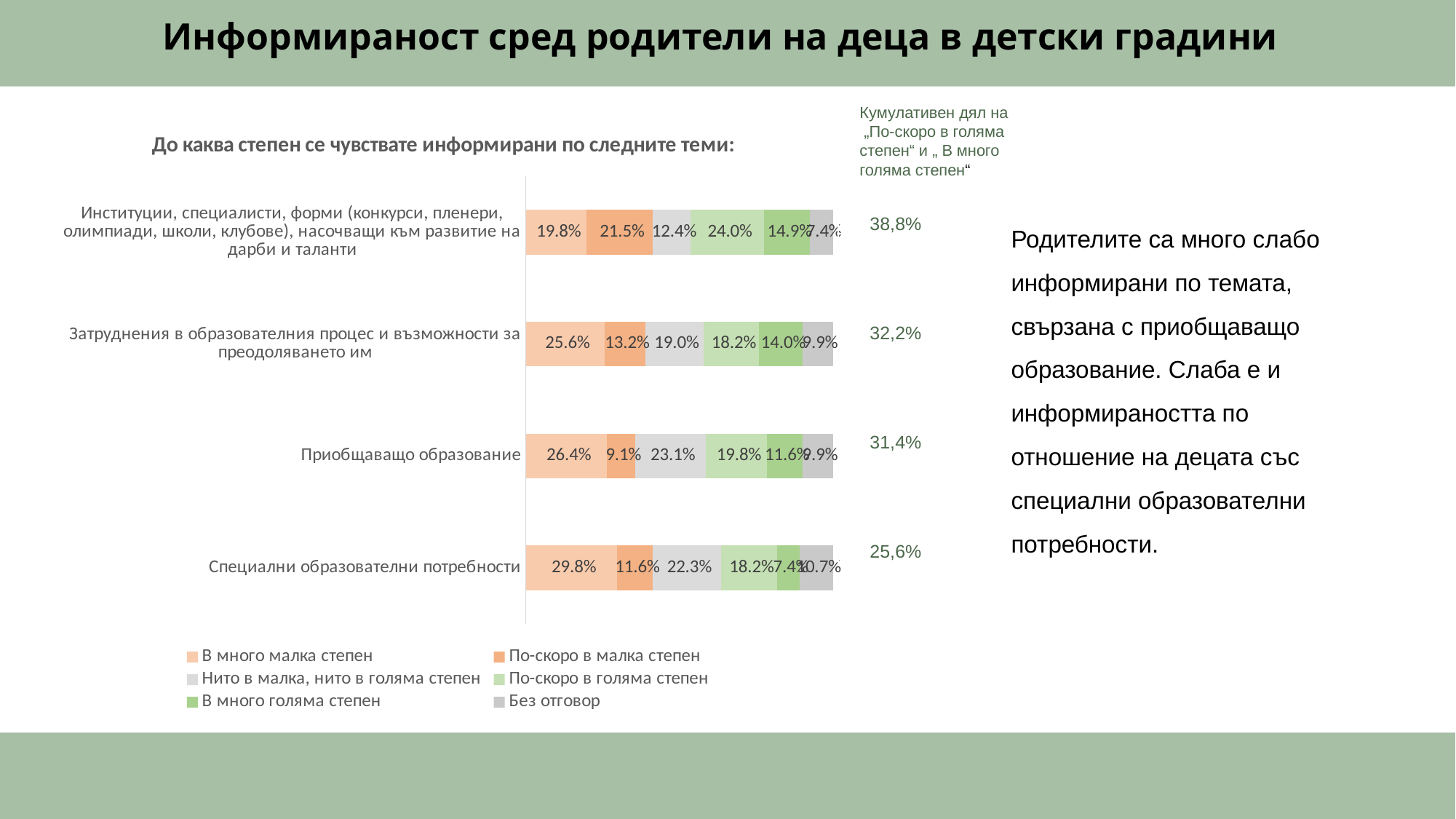
What is the value of "По-скоро в голяма степен" for "Институции, специалисти, форми (конкурси, пленери, олимпиади, школи, клубове), насочващи към развитие на дарби и таланти"? 24.0% What is the cumulative share of "По-скоро в голяма степен" and "В много голяма степен" shown for "Институции, специалисти, форми..."? 38,8% How many topics (categories) are plotted in the chart? 4 What is the value of "В много малка степен" for "Специални образователни потребности"? 29.8% Which topic has the highest value for "В много малка степен"? Специални образователни потребности What kind of chart is shown on the slide? Stacked bar chart What question is shown as the chart's title above the bars? До каква степен се чувствате информирани по следните теми: Which has the larger "Нито в малка, нито в голяма степен" value: "Приобщаващо образование" or "Затруднения в образователния процес и възможности за преодоляването им"? Приобщаващо образование What is the difference between the "В много малка степен" values for "Специални образователни потребности" and "Институции, специалисти, форми..."? 10.0 percentage points What is the value of "В много голяма степен" for "Затруднения в образователния процес и възможности за преодоляването им"? 14.0% Which topic has the lowest value for "По-скоро в малка степен"? Приобщаващо образование How many series does the chart legend list? 6